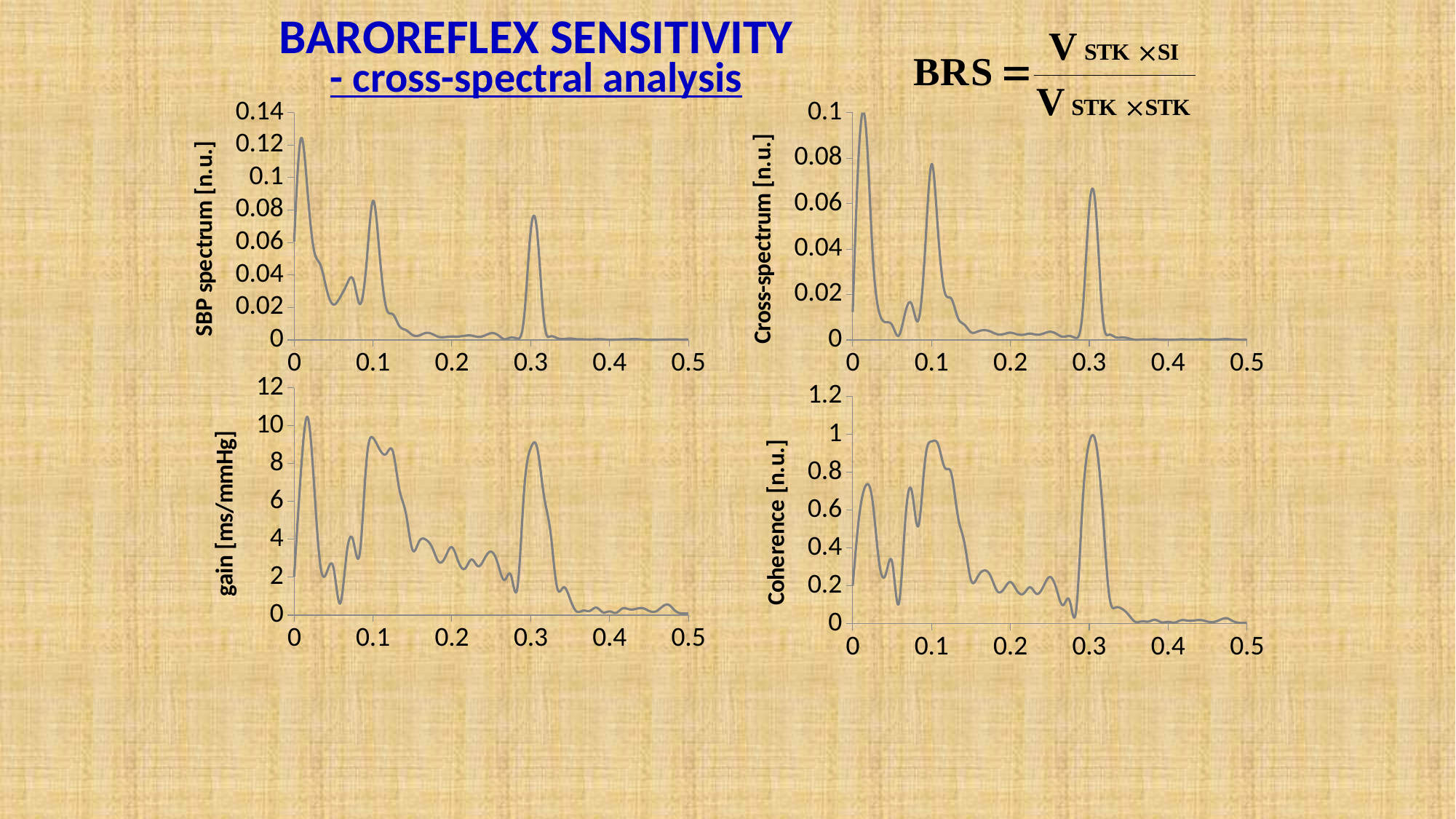
How many charts are shown on the slide? 4 In the 'gain [ms/mmHg]' chart, is the peak near x = 0 greater or less than 8? greater What is the y-axis label of the bottom-left chart? gain [ms/mmHg] In the 'Coherence [n.u.]' chart, is the peak near x = 0.3 greater or less than 0.8? greater In the 'Cross-spectrum [n.u.]' chart, is the peak near x = 0 greater or less than 0.08? greater In the 'SBP spectrum [n.u.]' chart, which peak is higher: the one near x = 0 or the one near x = 0.3? the one near x = 0 In the 'Coherence [n.u.]' chart, which peak is higher: the one near x = 0 or the one near x = 0.3? the one near x = 0.3 What kind of chart is the top-left chart labelled 'SBP spectrum [n.u.]'? line chart